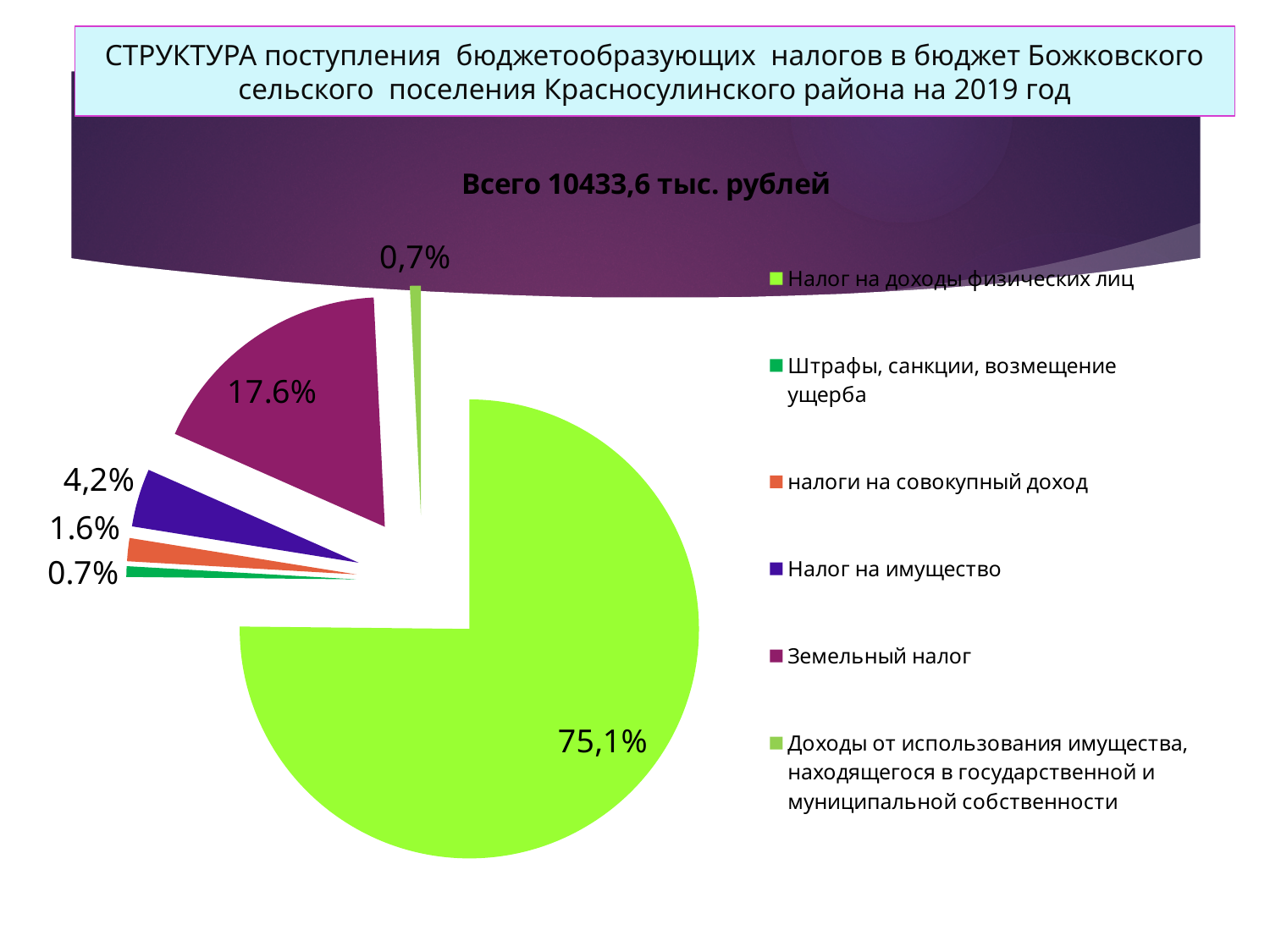
What share of the pie does Налог на доходы физических лиц account for? 75,1% What is the value shown for налоги на совокупный доход? 1.6% What is the value shown for Доходы от использования имущества, находящегося в государственной и муниципальной собственности? 0,7% What is the value shown for Штрафы, санкции, возмещение ущерба? 0.7% How many slices does the pie chart have? 6 What total amount is stated in the chart title? Всего 10433,6 тыс. рублей What is the value shown for Земельный налог? 17.6% Which is larger, Земельный налог or Налог на имущество? Земельный налог What is the value shown for Налог на имущество? 4,2% What is the difference between the shares of Земельный налог and Налог на имущество? 13.4% Which category has the largest slice of the pie? Налог на доходы физических лиц What kind of chart is shown on the slide? Pie chart